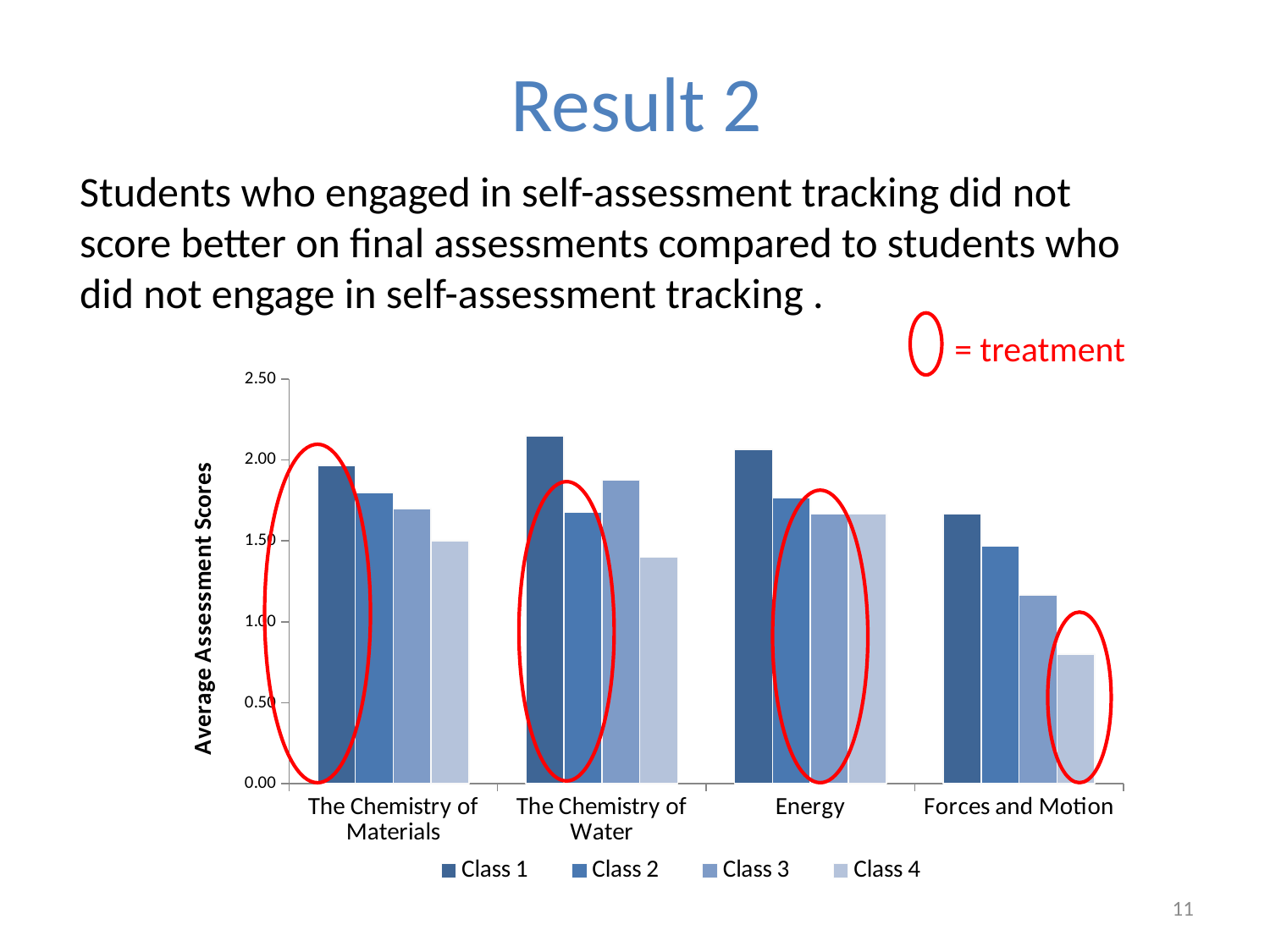
In The Chemistry of Water, which is larger: the value for Class 2 or Class 3? Class 3 Is the value for Class 1 in The Chemistry of Water greater or less than 2.00? greater What is the title of the vertical axis? Average Assessment Scores Which class has the lowest bar in The Chemistry of Water? Class 4 What kind of chart is shown on the slide? bar chart Which class has the highest bar in Forces and Motion? Class 1 In Forces and Motion, do the bars rise or fall from Class 1 to Class 4? fall Is the value for Class 4 in The Chemistry of Water greater or less than 1.50? less How many categories are shown on the x axis? 4 Which series does the lightest-coloured bar represent? Class 4 Is the value for Class 4 in Forces and Motion greater or less than 1.00? less How many series does the legend list? 4